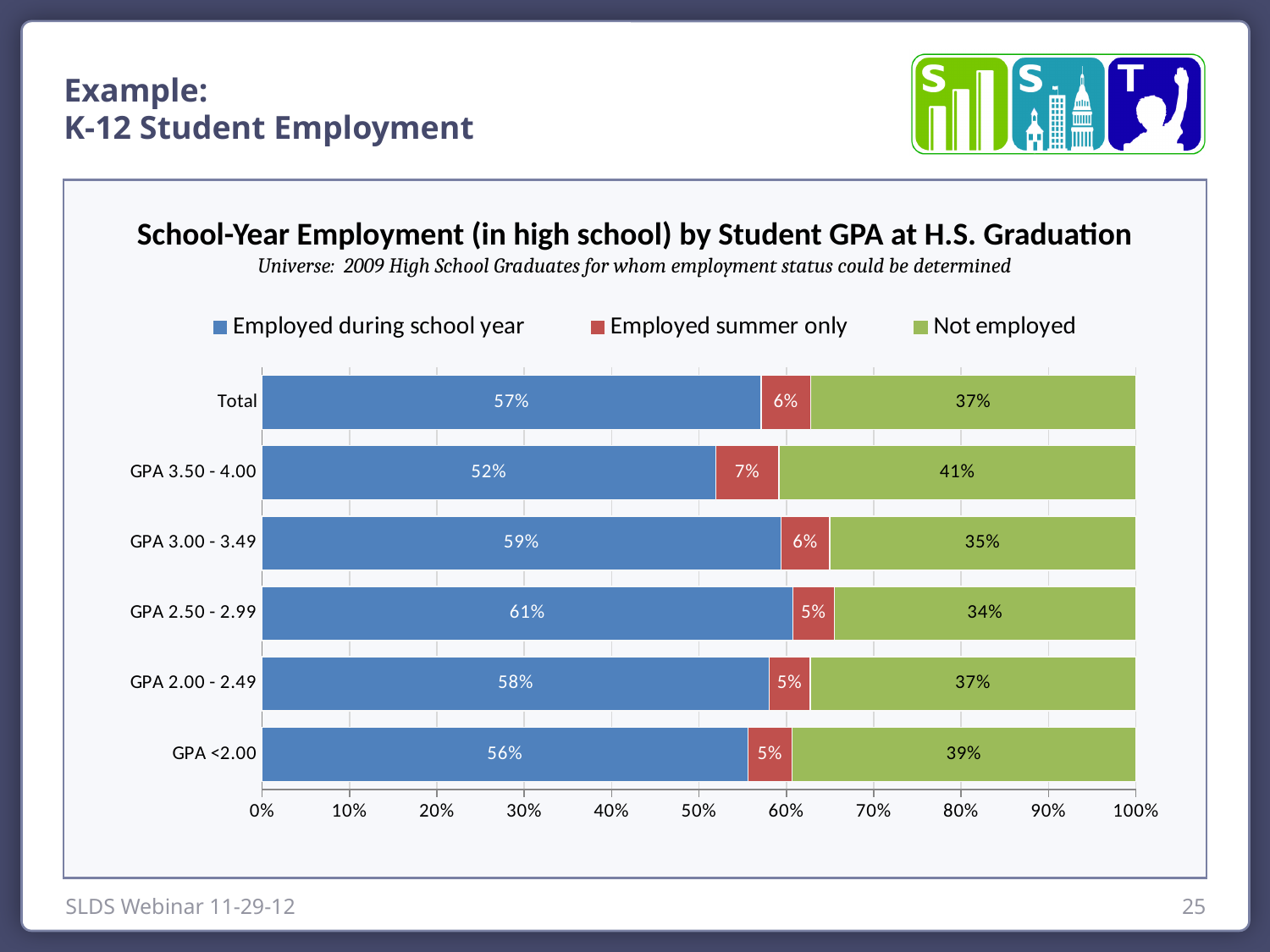
What is the 'Employed summer only' value for the Total category? 6% Which category has the highest 'Not employed' percentage? GPA 3.50 - 4.00 What percentage of students with GPA 3.50 - 4.00 were employed during the school year? 52% What is the difference between the 'Not employed' percentages for GPA 3.50 - 4.00 and GPA 2.50 - 2.99? 7% Is the 'Employed during school year' value larger for GPA 3.00 - 3.49 or GPA 2.00 - 2.49? GPA 3.00 - 3.49 Which category has the lowest percentage employed during the school year? GPA 3.50 - 4.00 How many categories are shown on the vertical axis of the chart? 6 What type of chart is shown on the slide? Stacked bar chart What is the title of the chart? School-Year Employment (in high school) by Student GPA at H.S. Graduation How many series does the legend list? 3 Which GPA category has the highest percentage employed during the school year? GPA 2.50 - 2.99 What percentage of students with GPA <2.00 were not employed? 39%